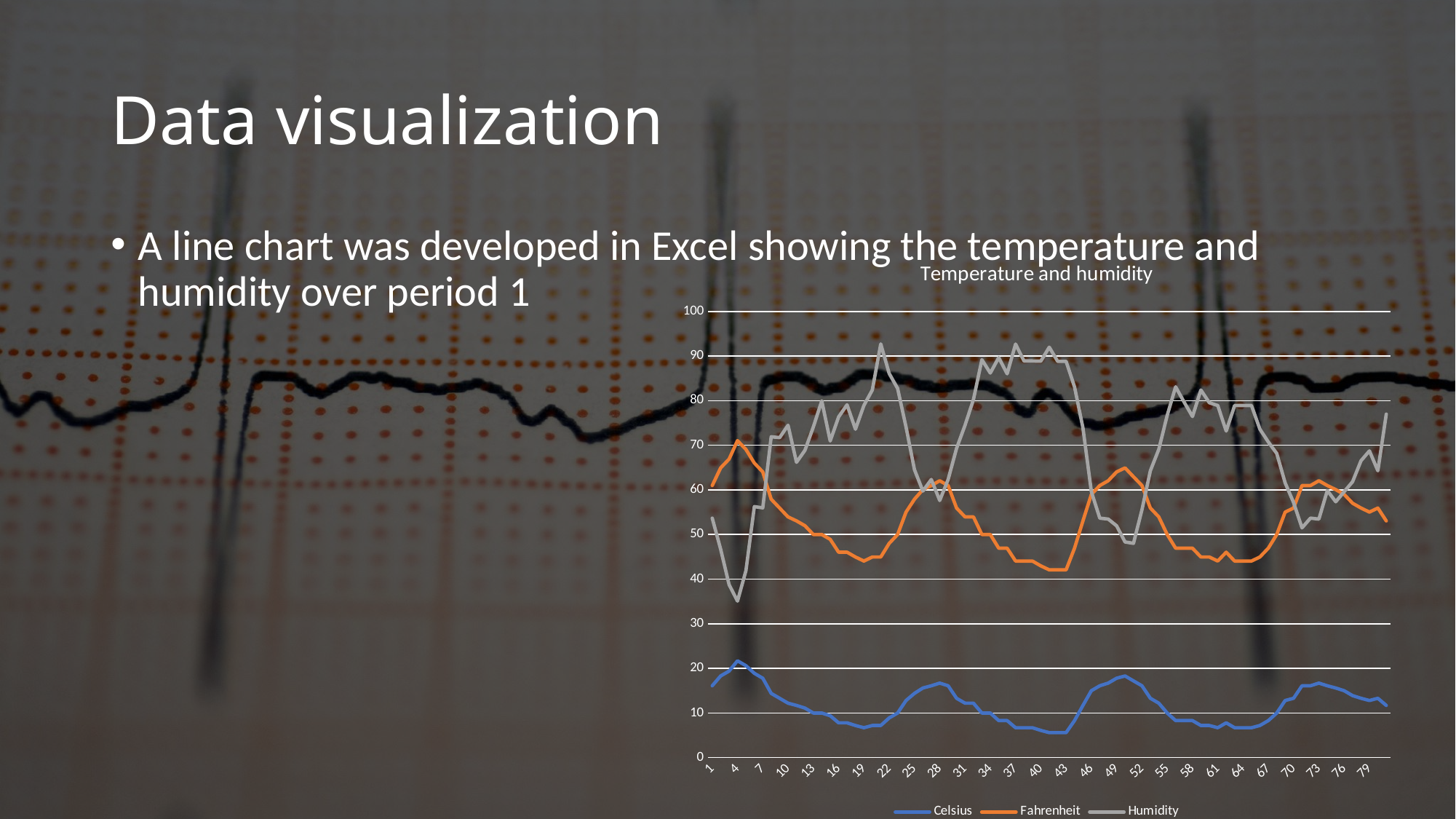
How many series does the legend of the chart list? 3 What is the title of the chart? Temperature and humidity Which series stays lowest across the whole chart? Celsius What kind of chart is shown on the slide? line chart Is the Humidity value at x = 4 greater or less than 40? less Which series is drawn in orange in the chart? Fahrenheit Is the Fahrenheit value at x = 43 greater or less than 50? less Which series reaches the highest value anywhere in the chart? Humidity Does the Celsius line rise or fall between x = 4 and x = 19? fall Is the Humidity value at x = 22 greater or less than 80? greater At x = 4, which is larger, the Fahrenheit value or the Humidity value? Fahrenheit